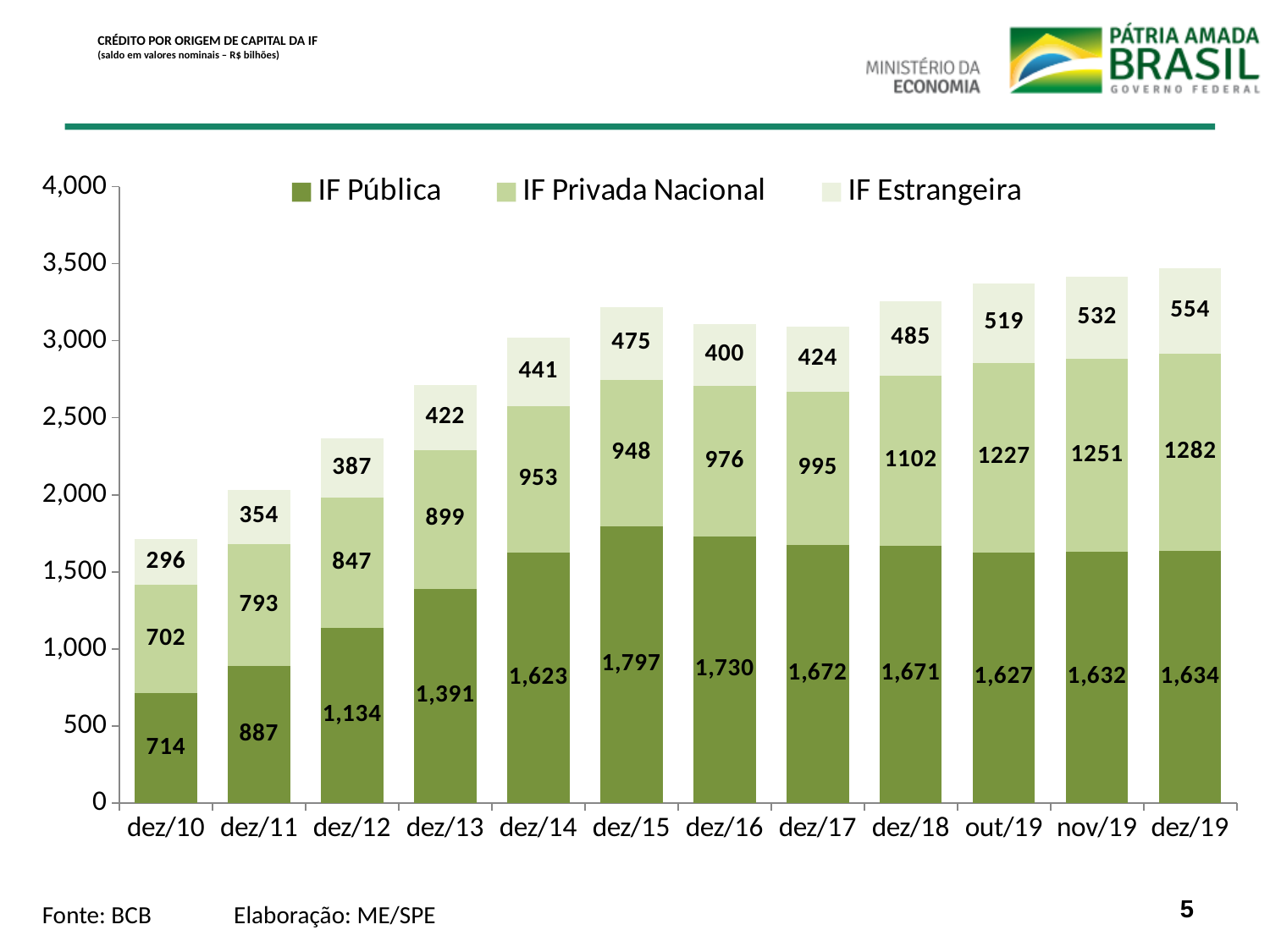
What is the value for IF Estrangeira in dez/19? 554 In which period is the IF Privada Nacional value lowest? dez/10 How many series does the legend list? 3 Which is larger, the IF Pública value for dez/16 or for dez/17? dez/16 How many periods are shown on the x axis? 12 What is the value for IF Pública in dez/15? 1,797 What is the difference between the IF Privada Nacional values for dez/19 and dez/18? 180 In which period is the IF Pública value highest? dez/15 Does the IF Estrangeira value rise or fall from dez/18 to dez/19? Rises What is the total of the stacked bar for dez/10? 1,712 What is the value for IF Privada Nacional in dez/13? 899 What kind of chart is shown on the slide? Stacked bar chart